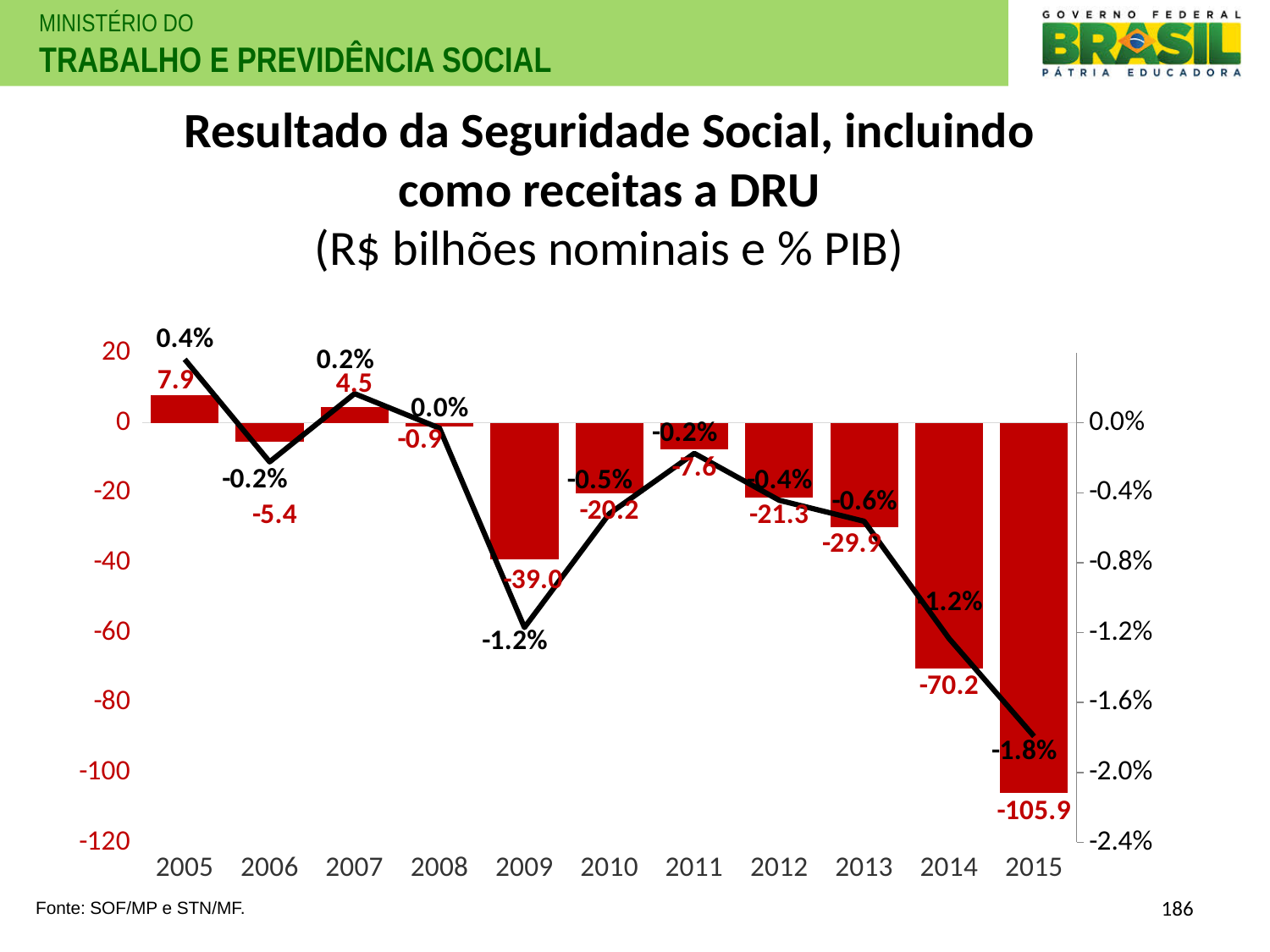
How many years are shown on the x axis? 11 What is the % PIB value shown for 2014? -1.2% Which year has the highest value in R$ billions? 2005 What is the value in R$ billions for 2015? -105.9 Which year has the larger value in R$ billions, 2010 or 2012? 2010 What is the difference between the R$ billions values for 2014 and 2015? 35.7 Do the R$ billions values generally rise or fall from 2011 to 2015? Fall What is the value in R$ billions for 2009? -39.0 Which year has the lowest value in R$ billions? 2015 What is the source cited below the chart? SOF/MP e STN/MF. What kind of chart is this? Combined bar and line chart What is the % PIB value shown for 2005? 0.4%